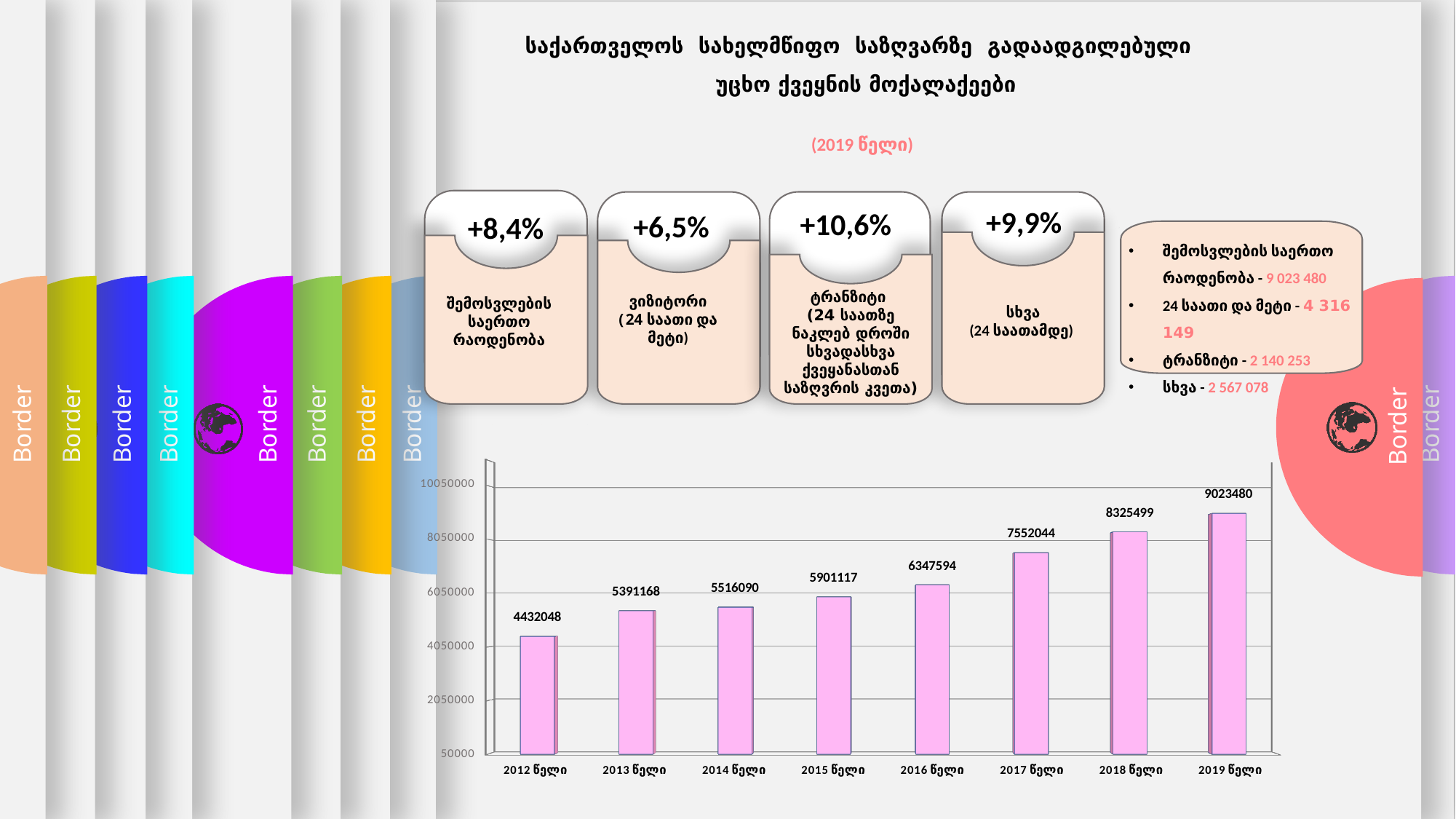
How many years (bars) are shown in the bar chart? 8 Which year has the highest value in the bar chart? 2019 წელი Do the values in the bar chart rise or fall from 2012 წელი to 2019 წელი? rise Which year has the lowest value in the bar chart? 2012 წელი What is the difference between the values for 2013 წელი and 2012 წელი? 959120 What kind of chart is shown at the bottom of the slide? bar chart What is the value shown for 2019 წელი in the bar chart? 9023480 What is the value shown for 2012 წელი in the bar chart? 4432048 What is the value shown for 2016 წელი in the bar chart? 6347594 Is the value for 2017 წელი greater or less than 8050000? less What is the difference between the values for 2019 წელი and 2018 წელი? 697981 Which is larger, the value for 2015 წელი or the value for 2017 წელი? 2017 წელი